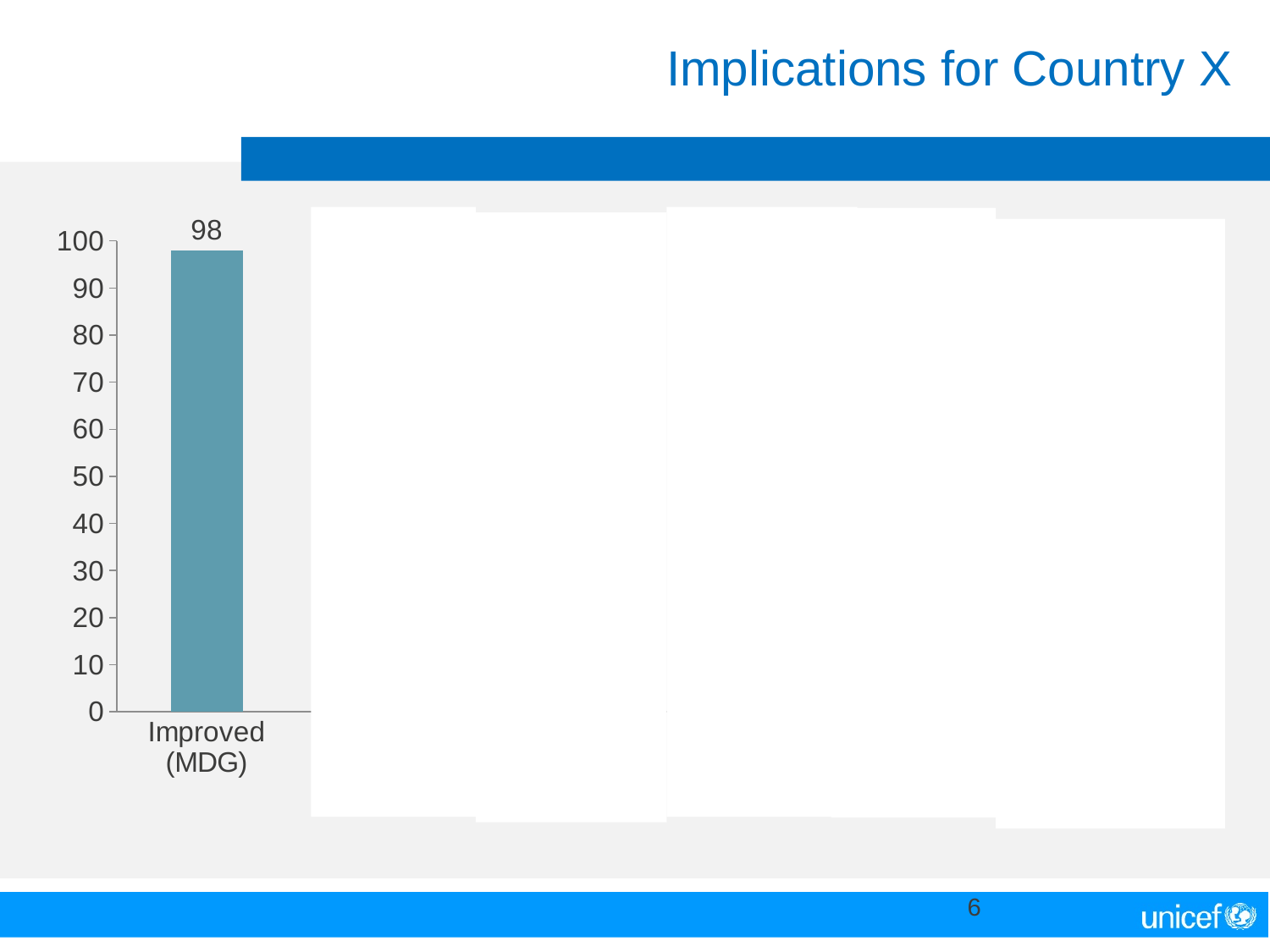
What is the highest value shown on the chart's vertical axis? 100 What is the value shown for Improved (MDG)? 98 What is the label of the category shown on the x axis of the chart? Improved (MDG) What kind of chart is shown on the slide? bar chart How many bars are visible in the chart? 1 Is the value for Improved (MDG) greater or less than 100? less Is the value for Improved (MDG) greater or less than 90? greater